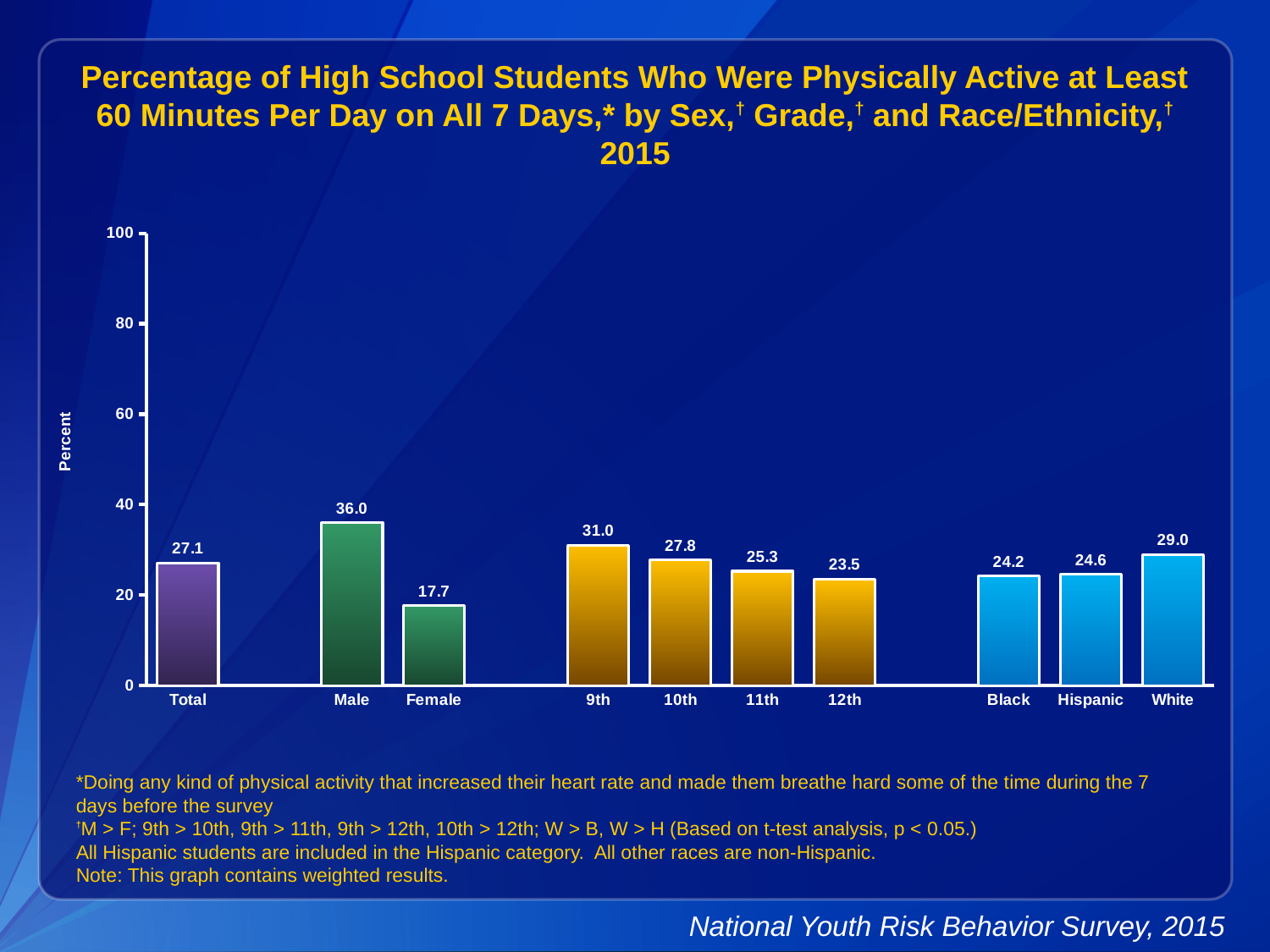
What is the value for 12th grade? 23.5 What is the value for Male? 36.0 How many bars are shown in the chart? 10 Is the value for Total greater or less than 20? greater Which is larger, the value for White or the value for Black? White What kind of chart is shown on the slide? Bar chart What is the value for Hispanic students? 24.6 What is the difference between the values for Male and Female? 18.3 Which category has the lowest value? Female Which category has the highest value? Male What is the difference between the values for 9th and 12th grade? 7.5 What is the value for Female? 17.7